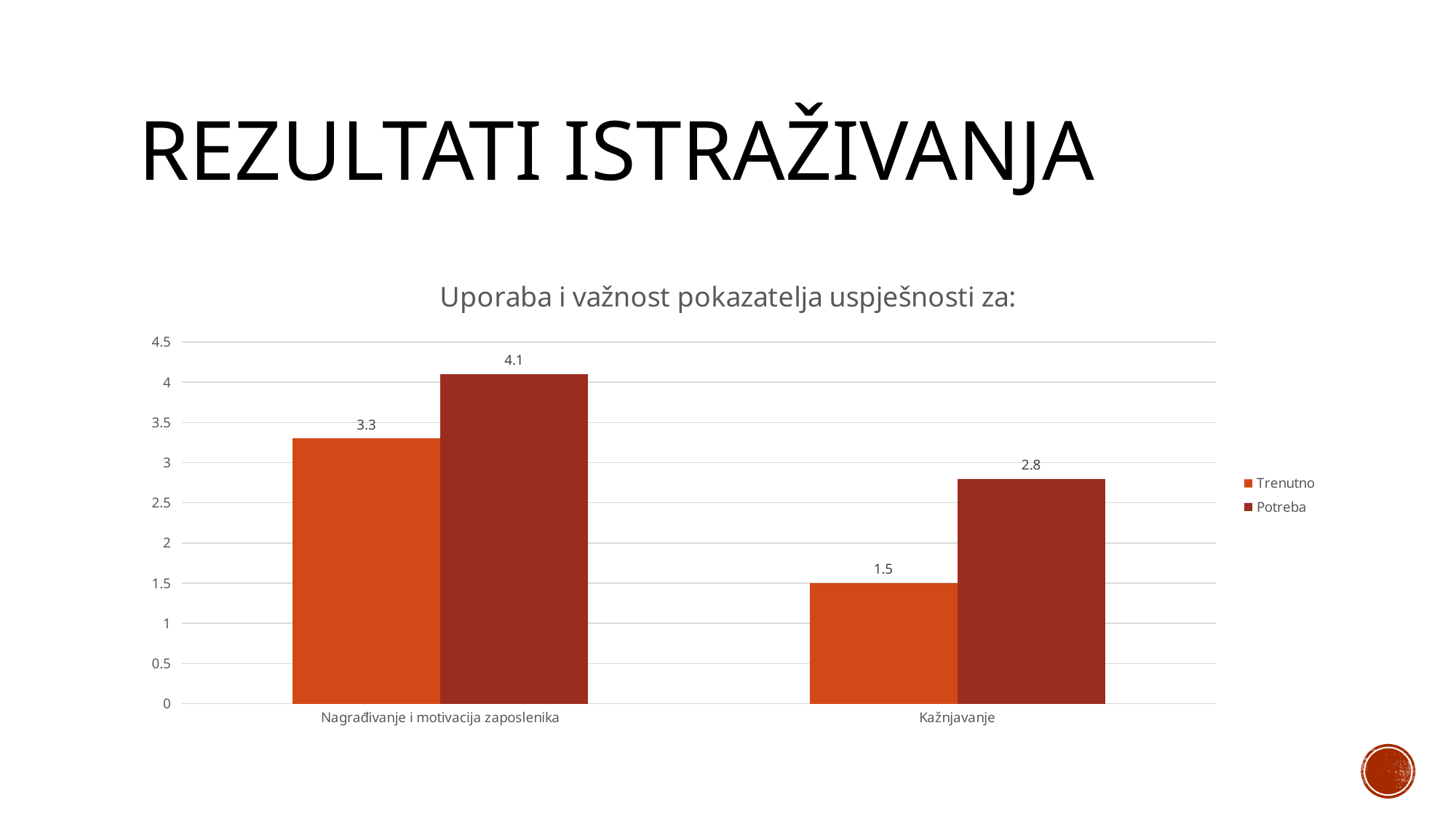
What is the Potreba value for Nagrađivanje i motivacija zaposlenika? 4.1 What type of chart is shown on the slide? Bar chart What is the Potreba value for Kažnjavanje? 2.8 Which category has the lowest Trenutno value? Kažnjavanje What is the difference between the Potreba and Trenutno values for Kažnjavanje? 1.3 Which category has the highest Potreba value? Nagrađivanje i motivacija zaposlenika How many categories are shown on the x axis? 2 What is the Trenutno value for Nagrađivanje i motivacija zaposlenika? 3.3 How many series does the legend list? 2 What is the difference between the Potreba and Trenutno values for Nagrađivanje i motivacija zaposlenika? 0.8 Which is larger for Kažnjavanje, Trenutno or Potreba? Potreba What is the Trenutno value for Kažnjavanje? 1.5